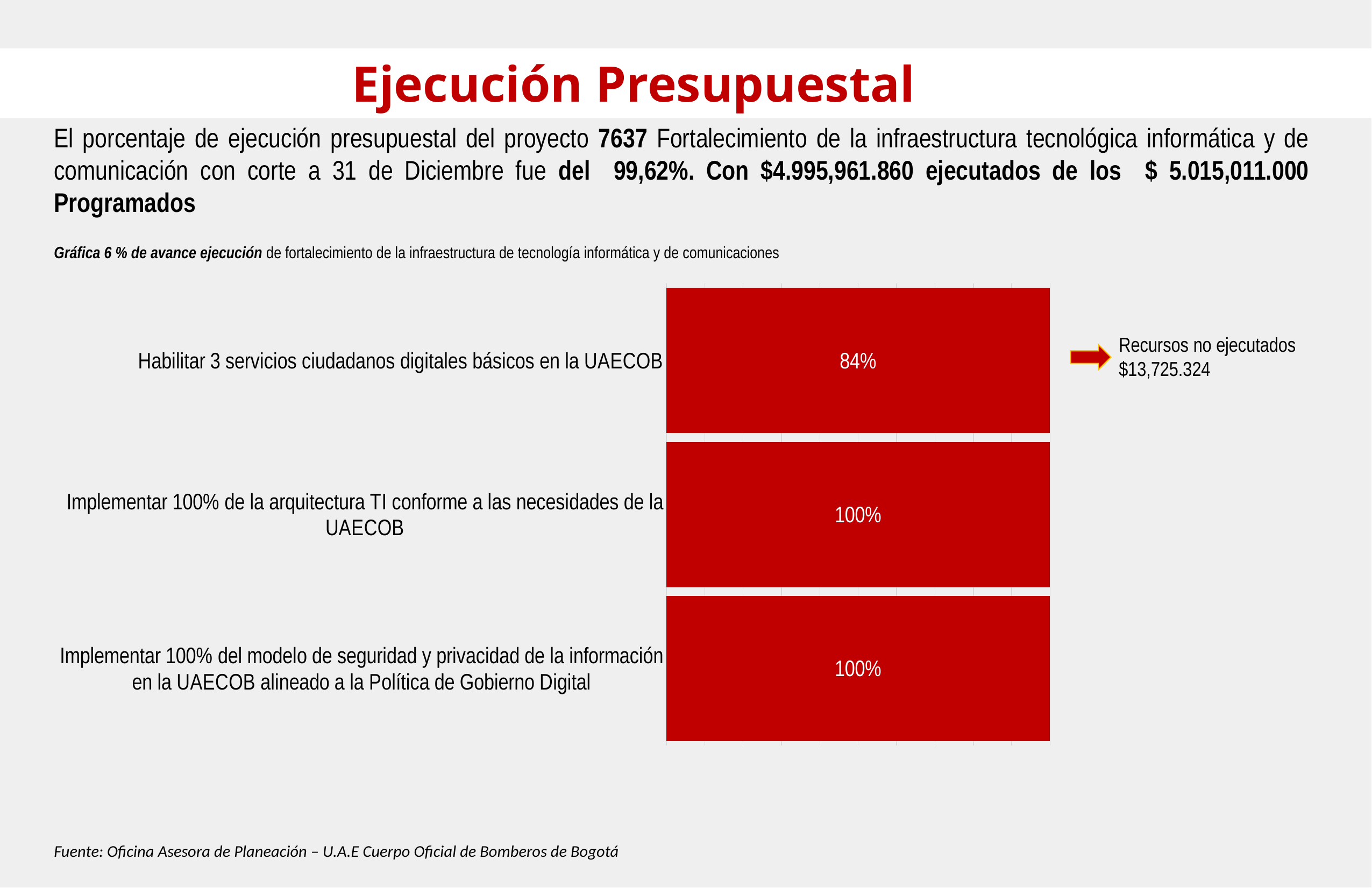
What is the value shown for "Implementar 100% del modelo de seguridad y privacidad de la información en la UAECOB alineado a la Política de Gobierno Digital"? 100% Which category has the lowest value in the chart? Habilitar 3 servicios ciudadanos digitales básicos en la UAECOB Which is larger: the value for "Habilitar 3 servicios ciudadanos digitales básicos en la UAECOB" or the value for "Implementar 100% del modelo de seguridad y privacidad de la información en la UAECOB alineado a la Política de Gobierno Digital"? Implementar 100% del modelo de seguridad y privacidad de la información en la UAECOB alineado a la Política de Gobierno Digital What is the value shown for "Implementar 100% de la arquitectura TI conforme a las necesidades de la UAECOB"? 100% What amount of "Recursos no ejecutados" is indicated next to the first bar? $13,725.324 What is the difference between the value for "Implementar 100% de la arquitectura TI conforme a las necesidades de la UAECOB" and the value for "Habilitar 3 servicios ciudadanos digitales básicos en la UAECOB"? 16% How many categories in the chart have a value of 100%? 2 What is the value shown for "Habilitar 3 servicios ciudadanos digitales básicos en la UAECOB"? 84% What kind of chart is shown on the slide? Bar chart How many categories are shown in the chart? 3 What colour are the bars in the chart? Red